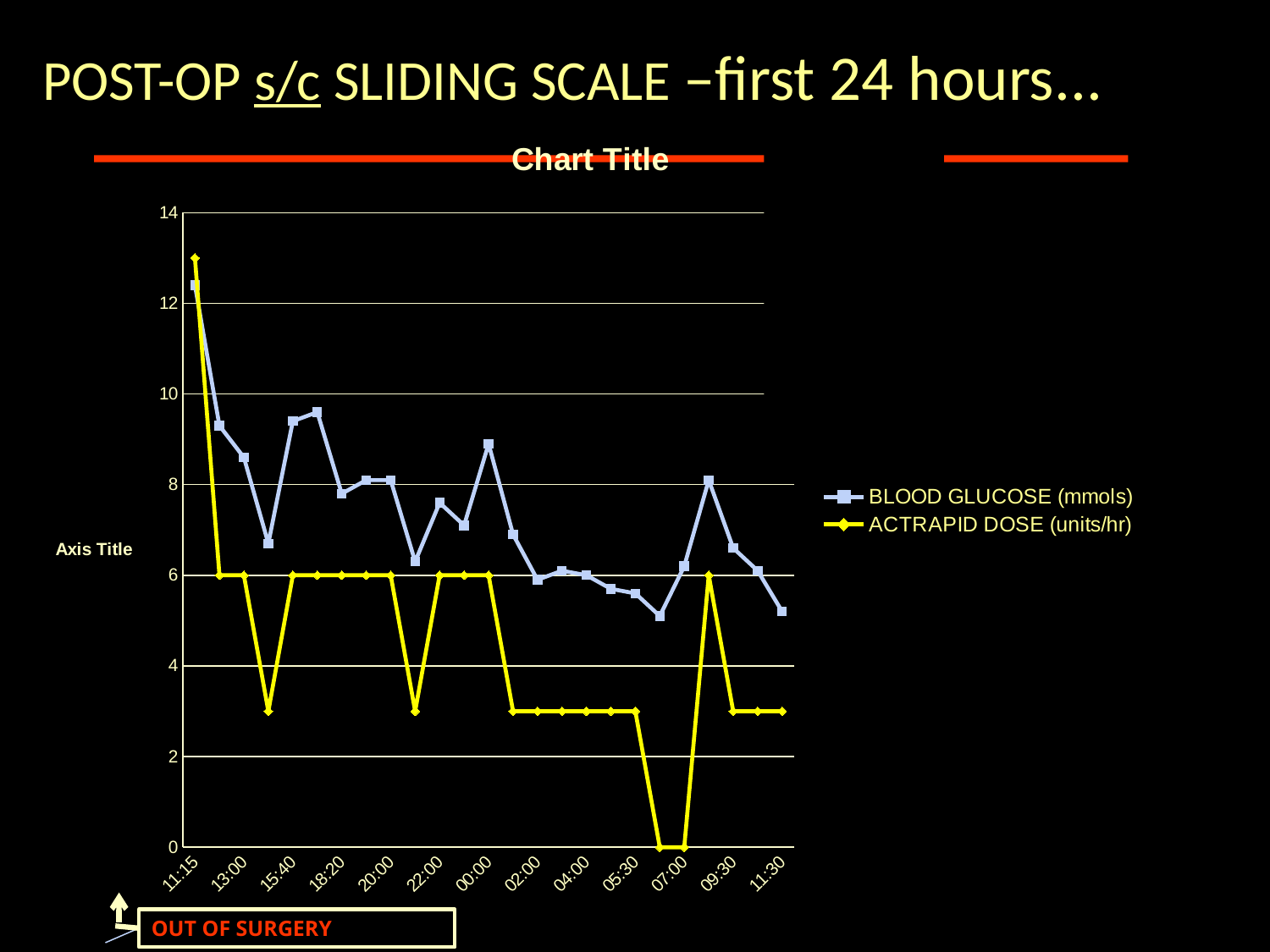
What is the ACTRAPID DOSE (units/hr) value at 02:00? 3 Is the BLOOD GLUCOSE (mmols) value at 11:15 greater or less than 12? greater What is the ACTRAPID DOSE (units/hr) value at 13:00? 6 How many series does the chart legend list? 2 What kind of chart is shown on the slide? line chart How many time labels are shown on the x axis of the chart? 13 At which time label is the ACTRAPID DOSE (units/hr) value highest? 11:15 Overall, does the BLOOD GLUCOSE (mmols) line rise or fall from 11:15 to 11:30? fall Is the BLOOD GLUCOSE (mmols) value at 11:30 greater or less than 6? less At 13:00, which series has the larger value, BLOOD GLUCOSE (mmols) or ACTRAPID DOSE (units/hr)? BLOOD GLUCOSE (mmols) At which time label is the BLOOD GLUCOSE (mmols) value highest? 11:15 What is the ACTRAPID DOSE (units/hr) value at 07:00? 0